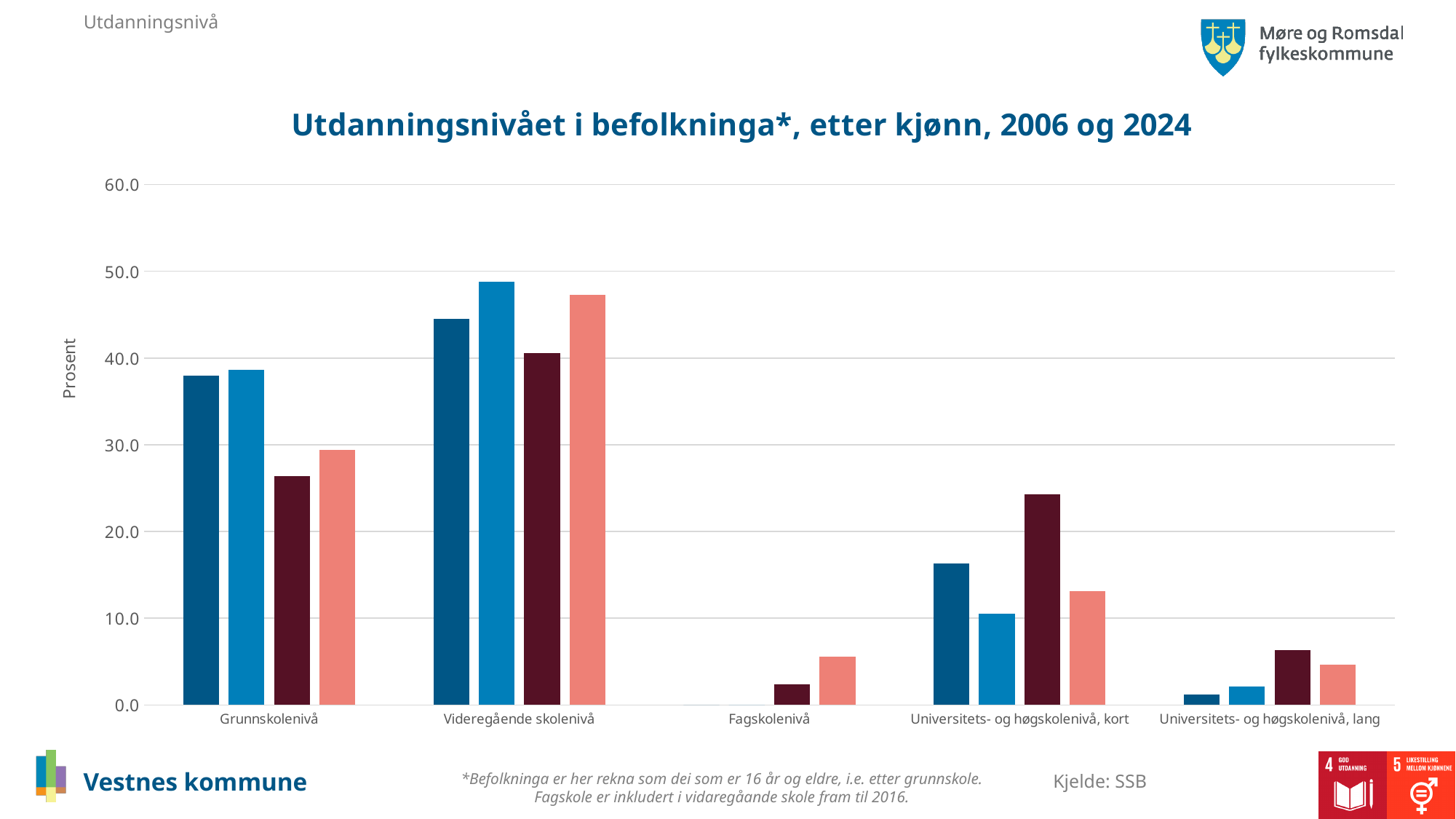
How many bars are plotted for each category? 4 Is the value of the dark red (third) bar for Universitets- og høgskolenivå, kort greater or less than 20? greater For Universitets- og høgskolenivå, kort, which is larger: the dark blue (first) bar or the light blue (second) bar? the dark blue (first) bar For Grunnskolenivå, which is larger: the dark red (third) bar or the salmon (fourth) bar? the salmon (fourth) bar What is the label on the vertical axis? Prosent What is the title of the chart? Utdanningsnivået i befolkninga*, etter kjønn, 2006 og 2024 Is the value of the dark blue (first) bar for Grunnskolenivå greater or less than 40? less Which category has the tallest bars overall? Videregående skolenivå What kind of chart is shown on the slide? bar chart Is the value of the salmon (fourth) bar for Fagskolenivå greater or less than 10? less How many education-level categories are shown on the x axis? 5 Which category has the lowest bars overall? Fagskolenivå